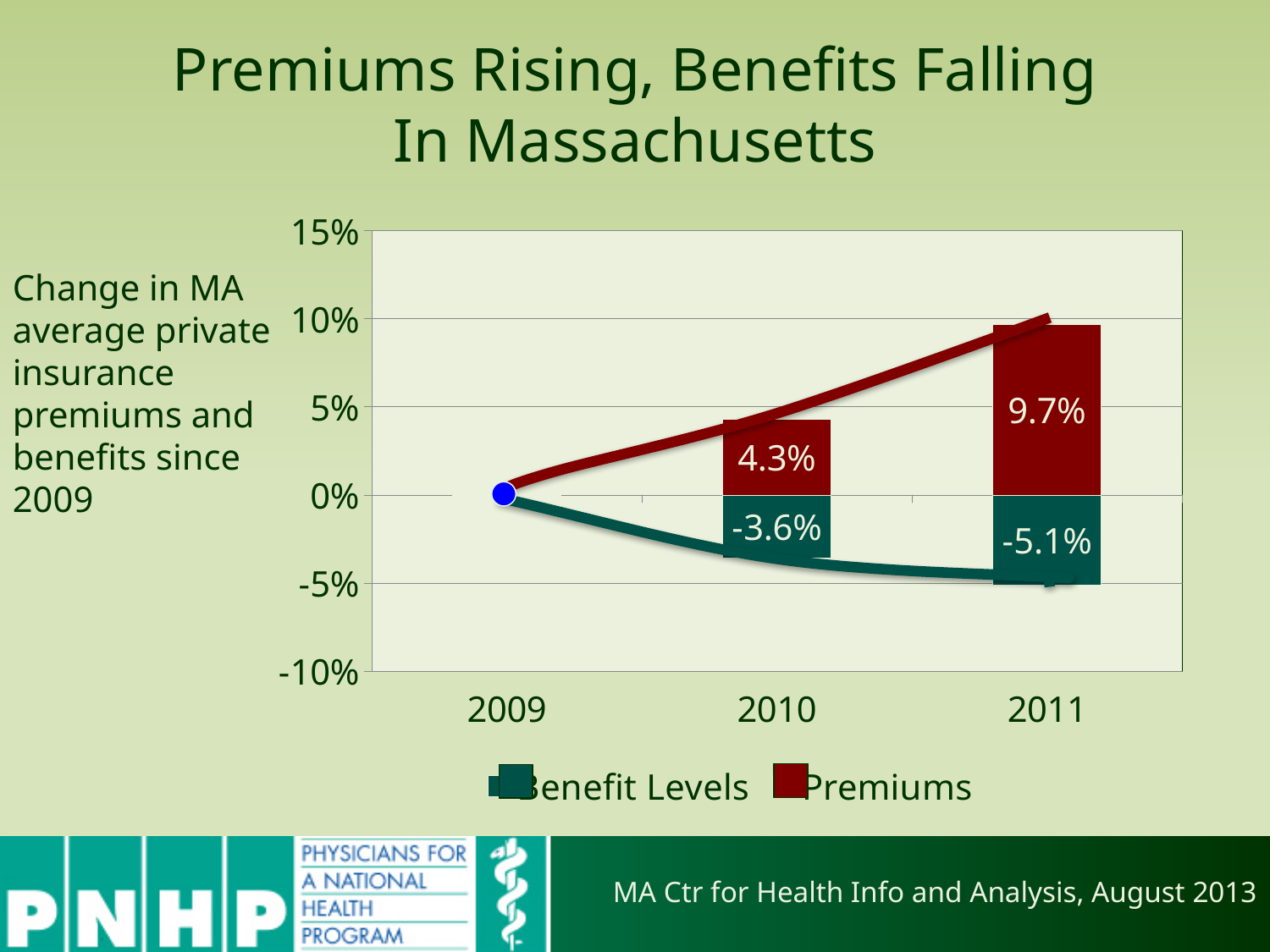
How many years are shown on the x axis? 3 What is the value for Benefit Levels in 2011? -5.1% What is the value for Premiums in 2011? 9.7% What is the difference between the Premiums values for 2011 and 2010? 5.4% What is the value for Premiums in 2010? 4.3% Do the Premiums values rise or fall from 2009 to 2011? rise Which is larger, the Premiums value for 2010 or for 2011? 2011 How many series does the legend list? 2 What is the value for Benefit Levels in 2010? -3.6% In which year is the Premiums value highest? 2011 Is the Premiums value for 2011 greater or less than 5%? greater In which year is the Benefit Levels value lowest? 2011